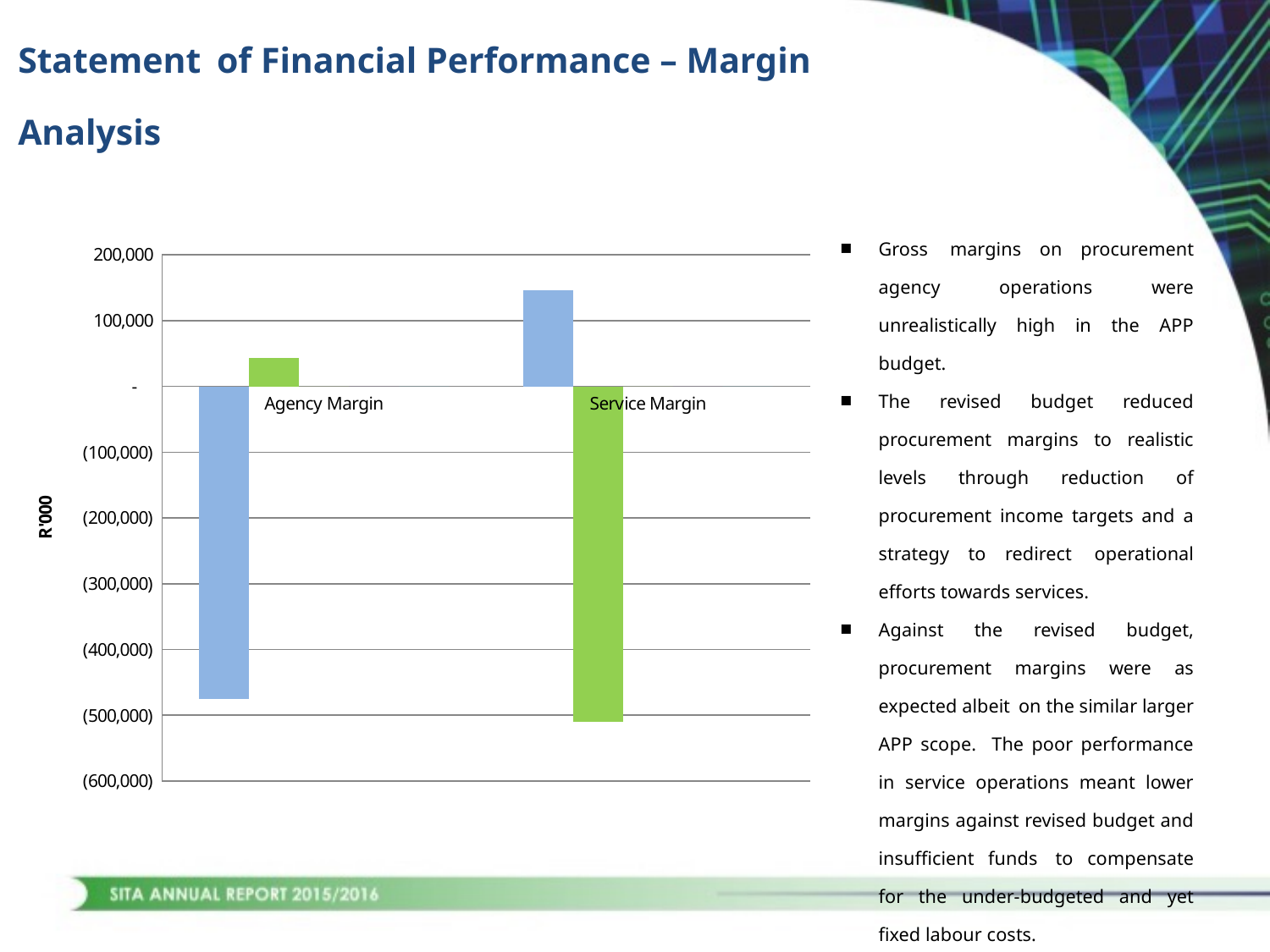
Which category has a positive (above zero) blue bar? Service Margin Is the green bar for Agency Margin above or below 100,000 on the axis? below Which category has a positive (above zero) green bar? Agency Margin Which category has the higher blue bar, Agency Margin or Service Margin? Service Margin Is the blue bar for Agency Margin above or below (400,000) on the axis? below What is the label on the vertical axis of the chart? R'000 Is the blue bar for Service Margin above or below 100,000 on the axis? above What are the two categories shown on the chart? Agency Margin and Service Margin How many categories are shown on the x axis of the chart? 2 What kind of chart is shown on the slide? bar chart